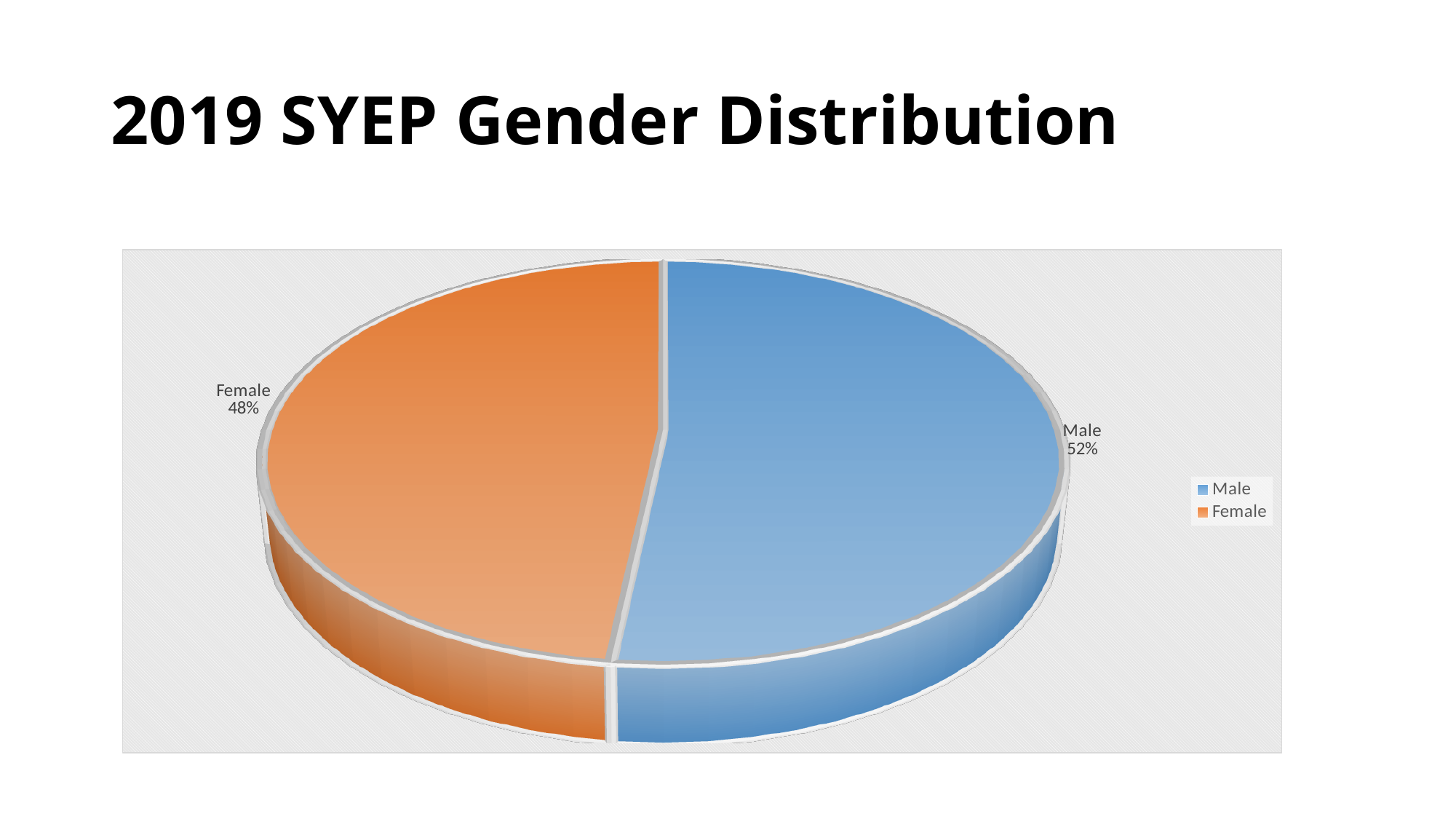
Which category has the largest share of the pie? Male Which share is larger, Male or Female? Male Which category has the smallest share of the pie? Female What is the difference in percentage points between the Male and Female shares? 4% What colour is the Female slice? Orange How many slices does the pie chart have? 2 How many entries does the legend list? 2 What percentage of the pie is labelled Female? 48% What percentage of the pie is labelled Male? 52% What is the title of the slide? 2019 SYEP Gender Distribution What kind of chart is shown on the slide? Pie chart